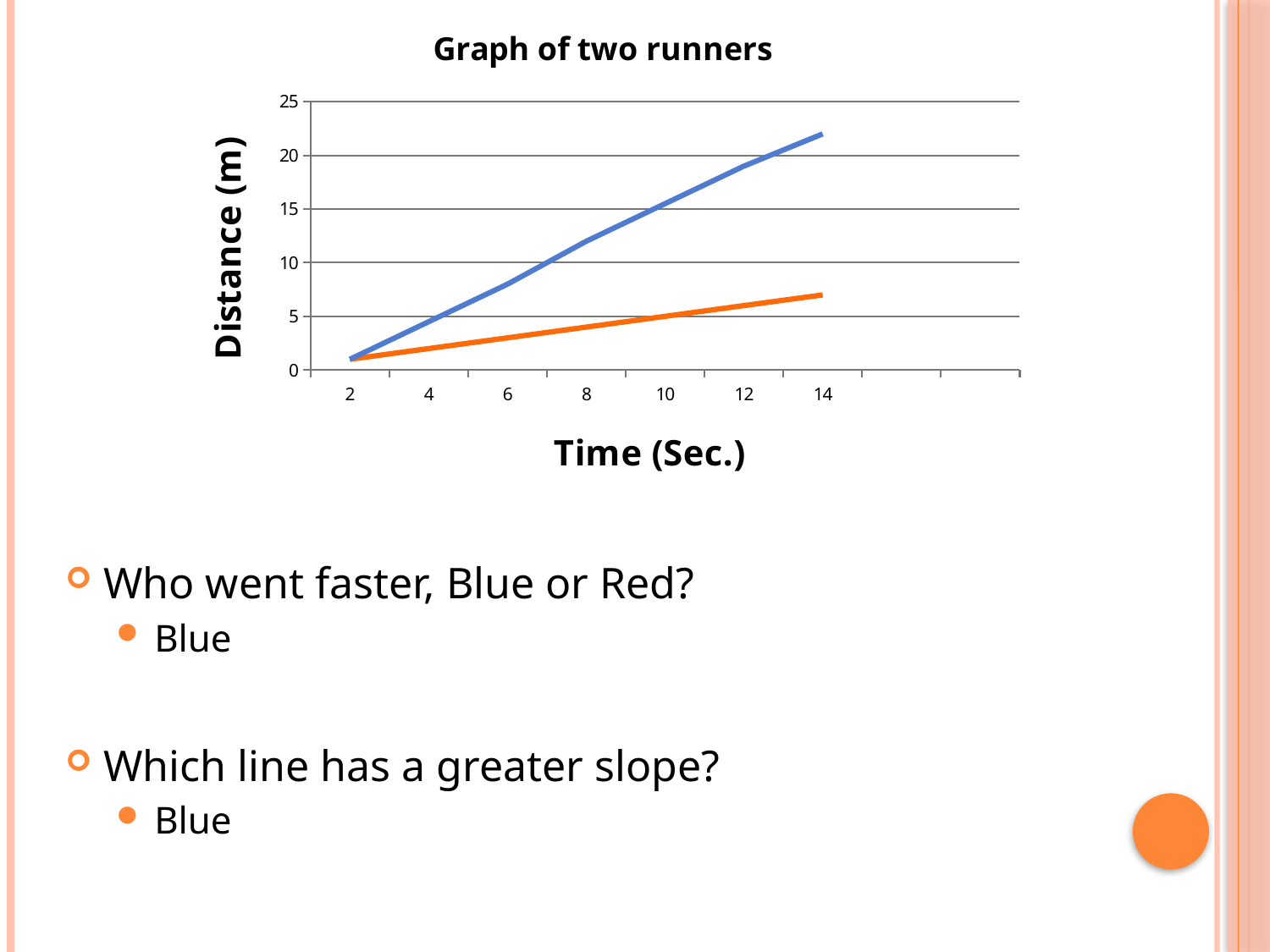
What is the label of the y axis? Distance (m) Is the value of the blue line at time 14 greater or less than 20? greater How many lines are plotted on the chart? 2 Is the value of the blue line at time 8 greater or less than 10? greater What kind of chart is shown on the slide? line chart At time 14, which line is higher, the blue line or the orange line? blue line Is the value of the orange line at time 14 greater or less than 10? less Which line has the steeper slope, the blue line or the orange line? blue line What is the title of the chart? Graph of two runners Does the blue line rise or fall as time increases? rise Does the orange line rise or fall as time increases? rise